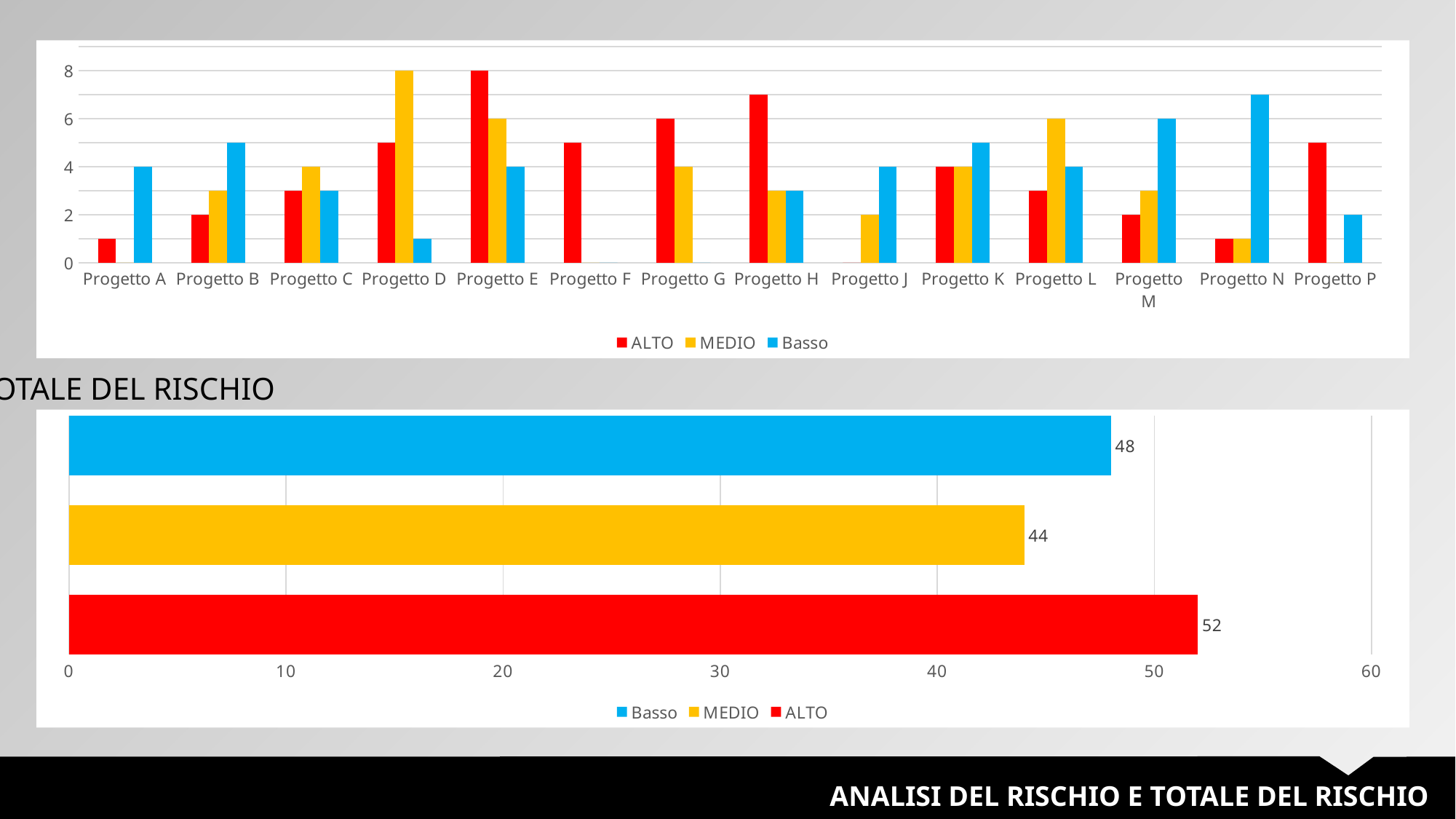
In the bottom chart, which category has the lowest value? MEDIO In the top chart, how many projects are shown on the x axis? 14 In the top chart, how many series does the legend list? 3 In the bottom chart, which colour represents Basso? Blue In the bottom chart, what is the difference between ALTO and MEDIO? 8 In the top chart, what is the ALTO value for Progetto E? 8 In the bottom chart, what is the value for Basso? 48 In the bottom chart, what is the value for ALTO? 52 In the top chart, which is larger for Progetto H: ALTO or Basso? ALTO In the top chart, what is the MEDIO value for Progetto D? 8 What type of chart is the bottom chart? Bar chart